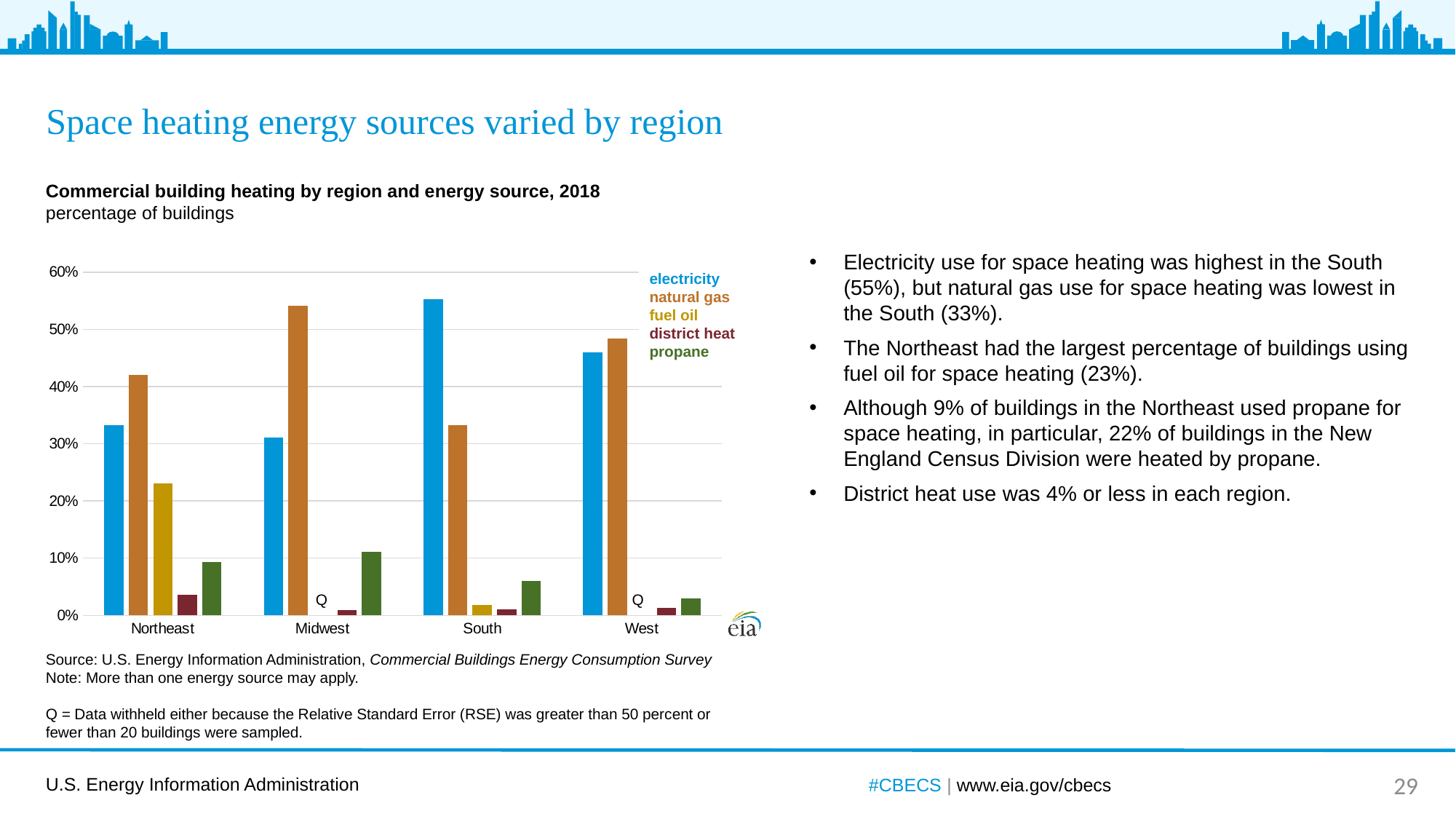
How many regions are shown on the x axis of the chart? 4 Is the natural gas value for the Midwest greater or less than 50%? greater What percentage of buildings in the South use electricity for space heating? 55% Which region has the highest percentage of buildings using fuel oil for space heating? Northeast How many energy sources does the chart's legend list? 5 Which region has the highest percentage of buildings using electricity for space heating? South What type of chart is shown on the slide? bar chart What does the label "Q" shown for fuel oil in the Midwest and West indicate? Data withheld Which region has the lowest percentage of buildings using natural gas for space heating? South Which region has the highest percentage of buildings using natural gas for space heating? Midwest What percentage of buildings in the Northeast use fuel oil for space heating? 23% Is the electricity value for the West greater or less than 40%? greater